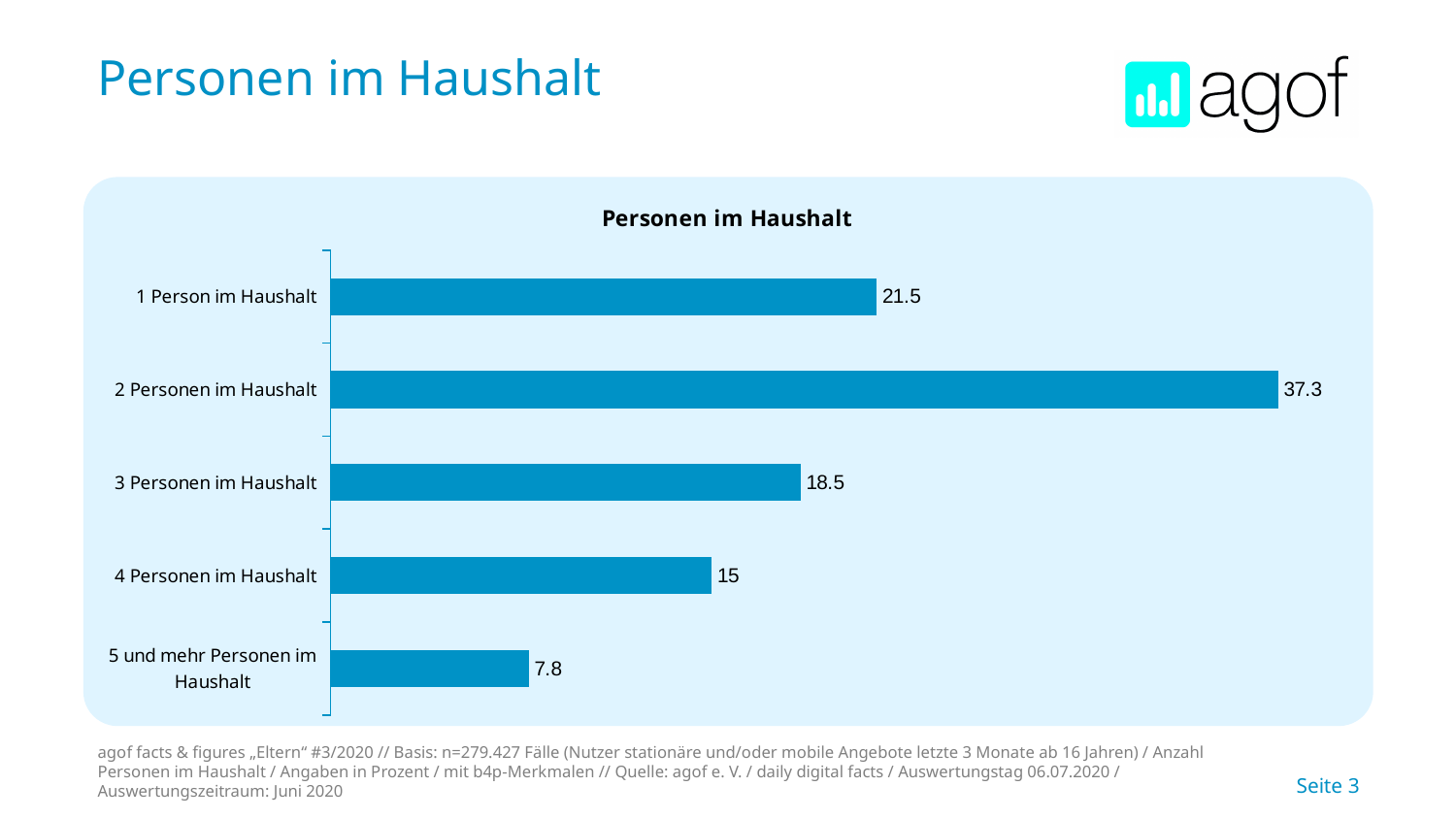
How many categories are shown in the chart? 5 Which is larger, the value for "1 Person im Haushalt" or "3 Personen im Haushalt"? 1 Person im Haushalt What colour are the bars in the chart? Blue What is the title of the chart? Personen im Haushalt What is the value for "2 Personen im Haushalt"? 37.3 What is the value for "4 Personen im Haushalt"? 15 What is the value for "5 und mehr Personen im Haushalt"? 7.8 Which category has the highest value? 2 Personen im Haushalt What is the difference between the values for "1 Person im Haushalt" and "3 Personen im Haushalt"? 3 Which category has the lowest value? 5 und mehr Personen im Haushalt What kind of chart is shown on the slide? Bar chart What is the difference between the values for "2 Personen im Haushalt" and "4 Personen im Haushalt"? 22.3